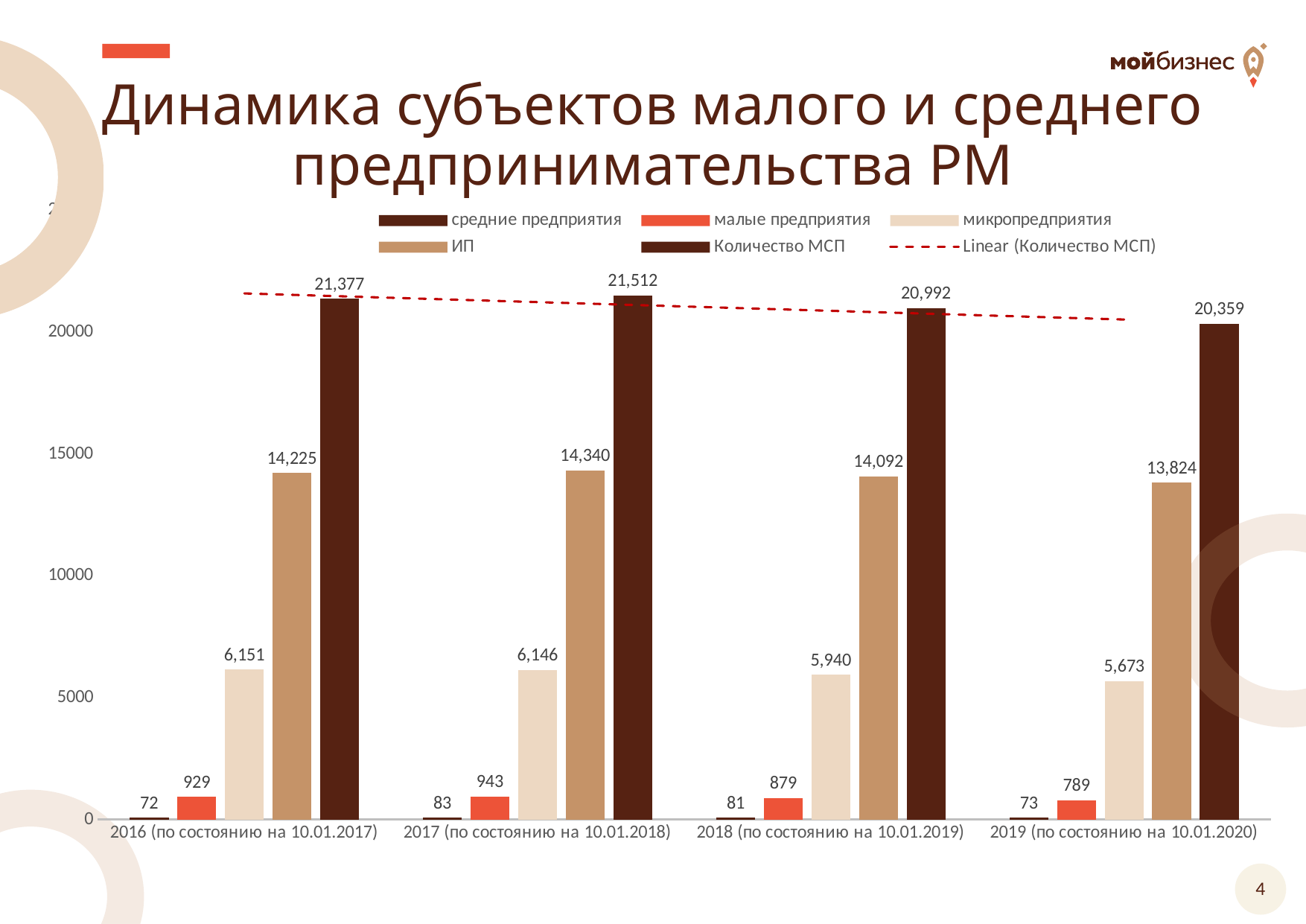
What is the difference between Количество МСП in 2017 (по состоянию на 10.01.2018) and 2019 (по состоянию на 10.01.2020)? 1,153 What is the value of малые предприятия for 2018 (по состоянию на 10.01.2019)? 879 How many entries does the legend list? 6 In which year is микропредприятия the lowest? 2019 (по состоянию на 10.01.2020) How many year categories are shown on the x axis? 4 What is the value of ИП for 2019 (по состоянию на 10.01.2020)? 13,824 What is the value of средние предприятия for 2016 (по состоянию на 10.01.2017)? 72 Which is larger: малые предприятия in 2016 (по состоянию на 10.01.2017) or in 2017 (по состоянию на 10.01.2018)? 2017 (по состоянию на 10.01.2018) Does Количество МСП rise or fall from 2017 (по состоянию на 10.01.2018) to 2019 (по состоянию на 10.01.2020)? Fall What kind of chart is shown on the slide? Bar chart What is the value of Количество МСП for 2017 (по состоянию на 10.01.2018)? 21,512 In which year is Количество МСП the highest? 2017 (по состоянию на 10.01.2018)